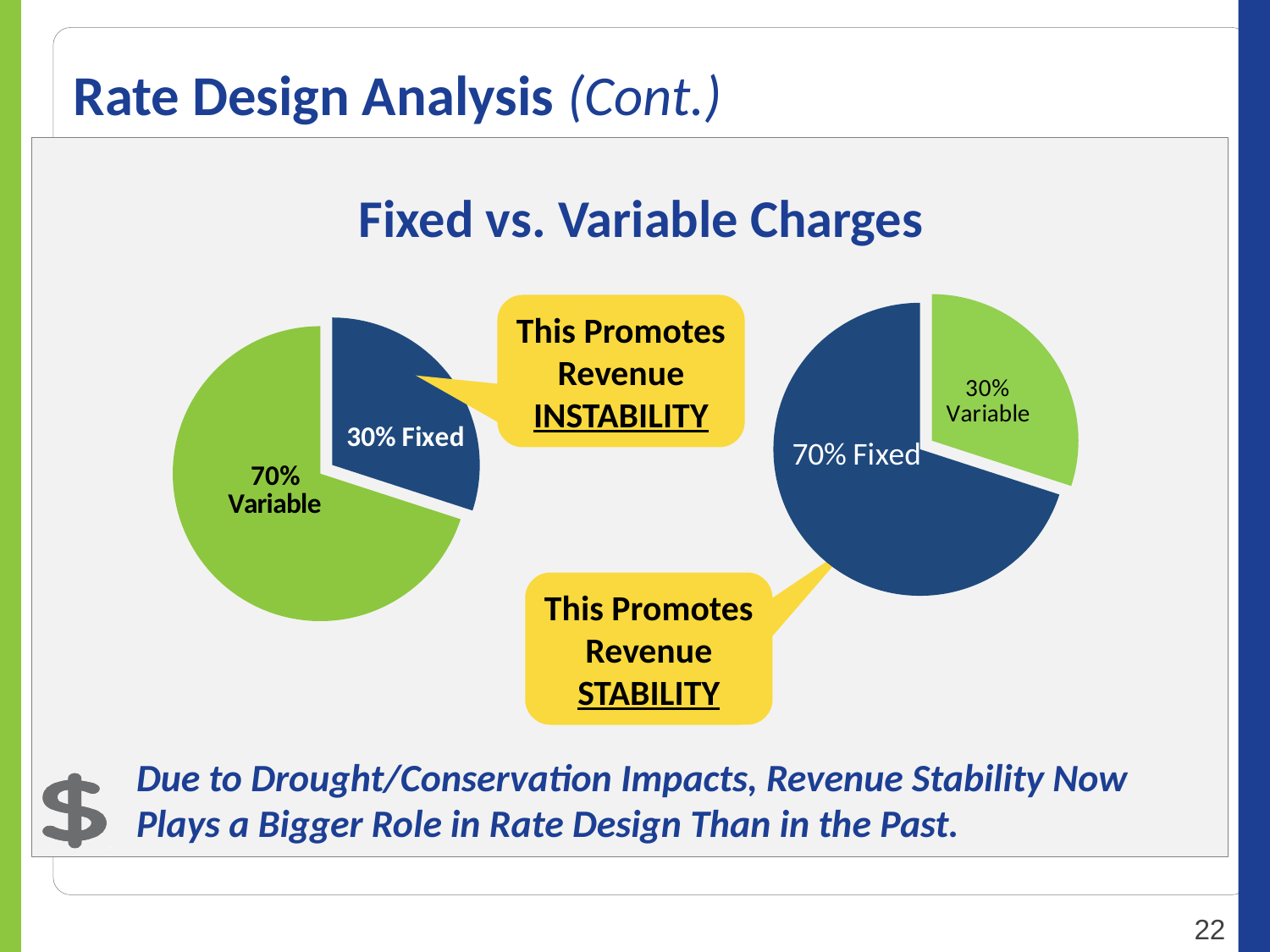
In the left pie chart, what share is labelled as Variable? 70% In the left pie chart, what share is labelled as Fixed? 30% In the right pie chart, what is the difference between the Fixed share and the Variable share? 40% In the right pie chart, which slice is larger, Fixed or Variable? Fixed How many slices does the right pie chart have? 2 In the left pie chart, what is the difference between the Variable share and the Fixed share? 40% What is the title shown above the two pie charts? Fixed vs. Variable Charges In the right pie chart, what share is labelled as Variable? 30% In the left pie chart, which slice is larger, Fixed or Variable? Variable What kind of chart is used on the left side of the slide? Pie chart In the right pie chart, what colour is the Fixed slice? Dark blue